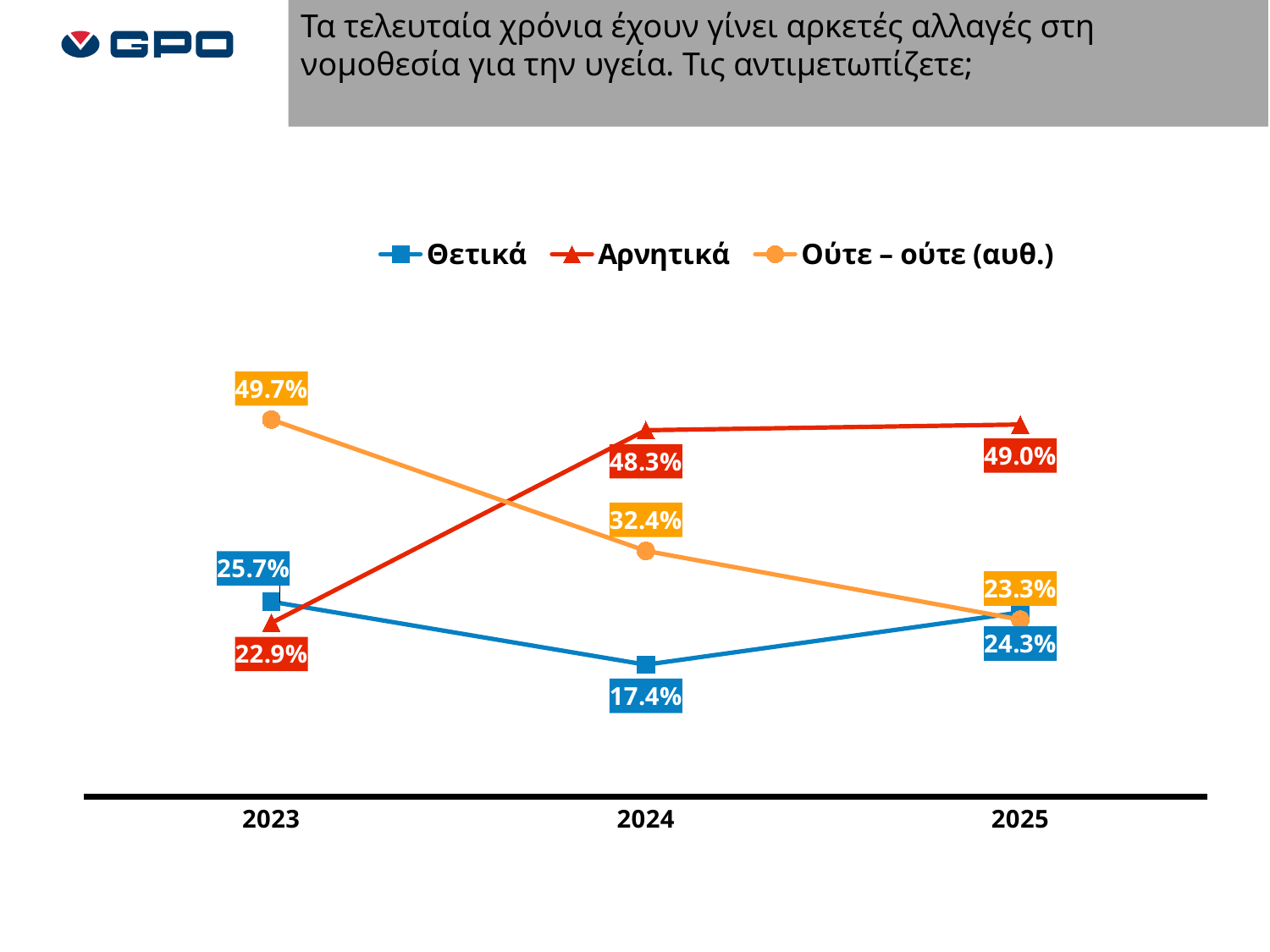
What is the difference between Αρνητικά and Θετικά in 2024? 30.9% Which series is drawn with triangle markers? Αρνητικά Which is larger in 2023, Θετικά or Αρνητικά? Θετικά What kind of chart is shown on the slide? line chart In which year is the value for Θετικά lowest? 2024 What is the value for Αρνητικά in 2024? 48.3% How many years are shown on the x axis? 3 Does the value for Ούτε – ούτε (αυθ.) rise or fall from 2023 to 2025? fall What is the value for Θετικά in 2025? 24.3% In which year is the value for Ούτε – ούτε (αυθ.) highest? 2023 How many series does the legend list? 3 What is the value for Ούτε – ούτε (αυθ.) in 2023? 49.7%